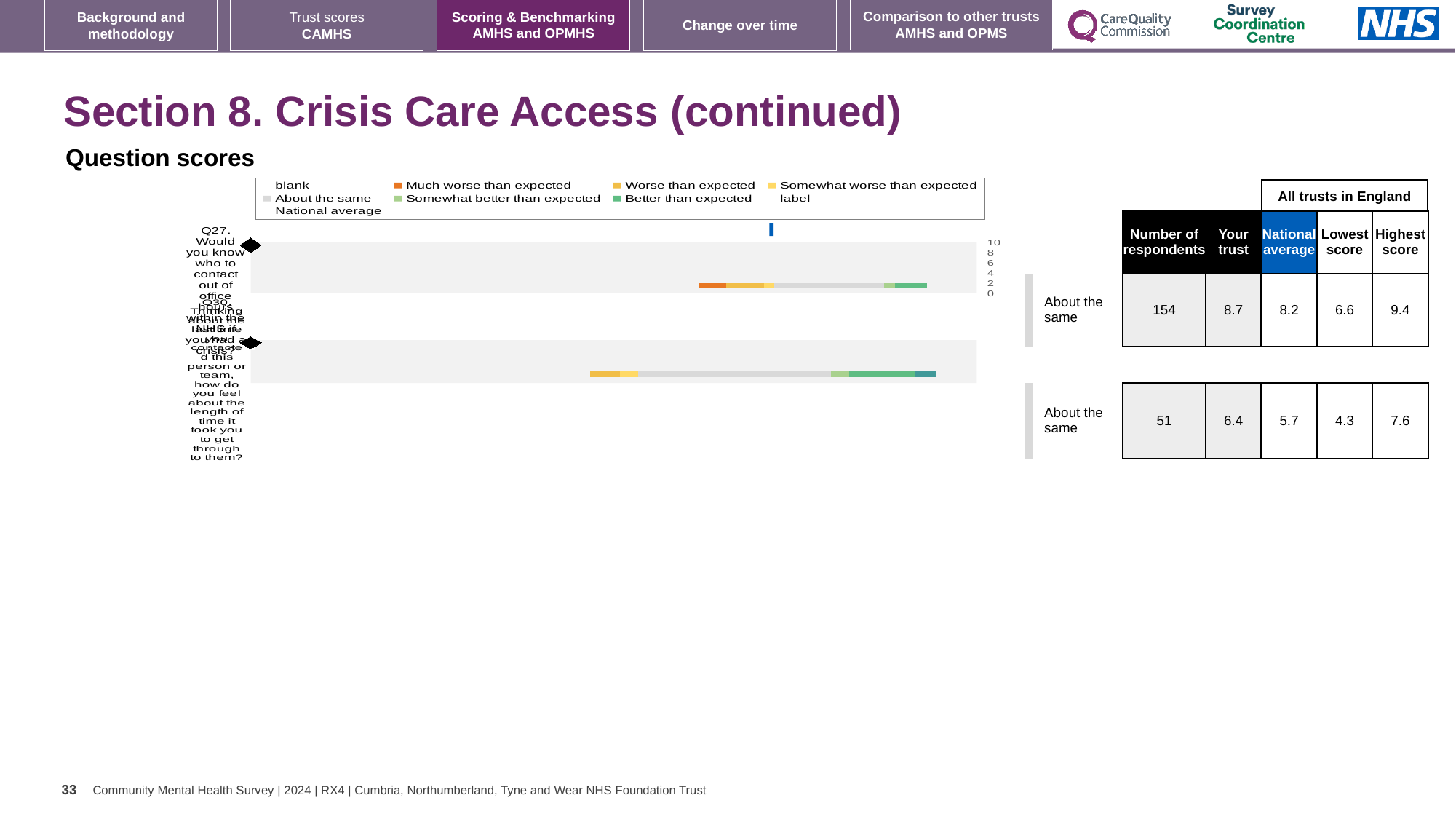
In the table beside the chart, what is the number of respondents for Q27? 154 In the table beside the chart, what is the highest score for Q30? 7.6 Which two questions are plotted in the bar chart? Q27 and Q30 In the table beside the chart, what is the lowest score for Q27? 6.6 What kind of chart is shown under 'Question scores'? bar chart How many question rows (categories) does the bar chart show? 2 In the table beside the chart, what is the difference between the 'Your trust' score and the national average for Q27? 0.5 What colour does the legend use for 'Much worse than expected'? orange In the table beside the chart, what is the 'Your trust' score for Q27? 8.7 In the table beside the chart, which question has the higher number of respondents, Q27 or Q30? Q27 In the table beside the chart, which is larger for Q30: the 'Your trust' score or the national average? Your trust In the table beside the chart, what is the national average for Q30? 5.7